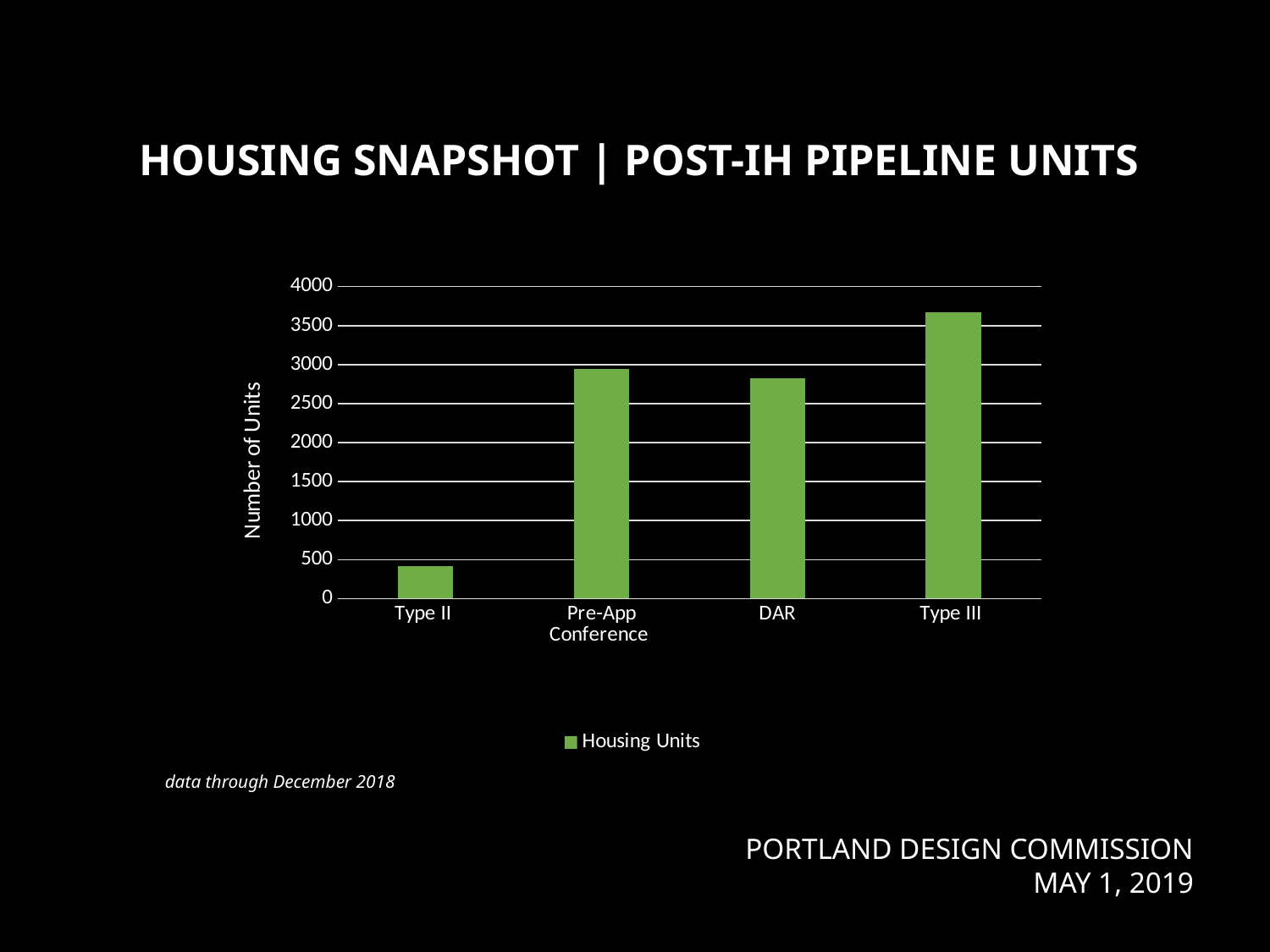
What kind of chart is shown on the slide? bar chart How many categories are shown on the x axis? 4 Is the value for Type II greater or less than 500? less Which is larger, the value for Type III or the value for DAR? Type III How many series does the legend list? 1 Which category has the highest number of units? Type III Is the value for DAR greater or less than 3000? less What is the label of the y axis? Number of Units Is the value for Pre-App Conference greater or less than 2500? greater Which category has the lowest number of units? Type II What series name is shown in the legend? Housing Units